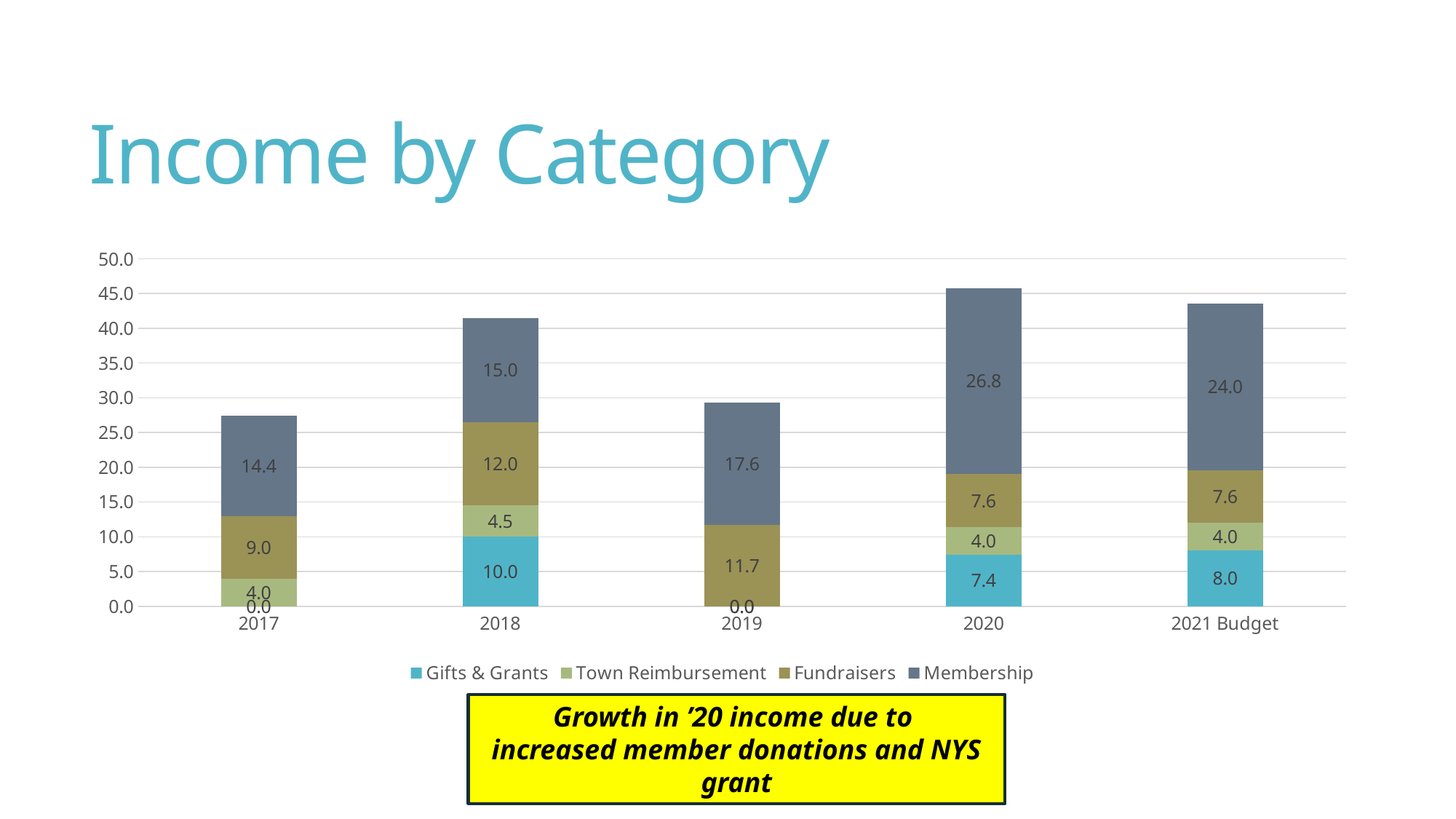
What is the Fundraisers value for 2018? 12.0 Which is larger, the Fundraisers value for 2017 or for 2019? 2019 How many series does the legend list? 4 What is the Gifts & Grants value for 2021 Budget? 8.0 How many categories are shown on the x axis? 5 Is the total height of the 2020 bar greater or less than 40.0? greater What is the total of the stacked bar for 2018? 41.5 What is the difference between the Membership value for 2020 and for 2021 Budget? 2.8 What is the Membership value for 2020? 26.8 What kind of chart is shown on the slide? Stacked bar chart Which year has the lowest Membership value? 2017 Which year has the highest Membership value? 2020